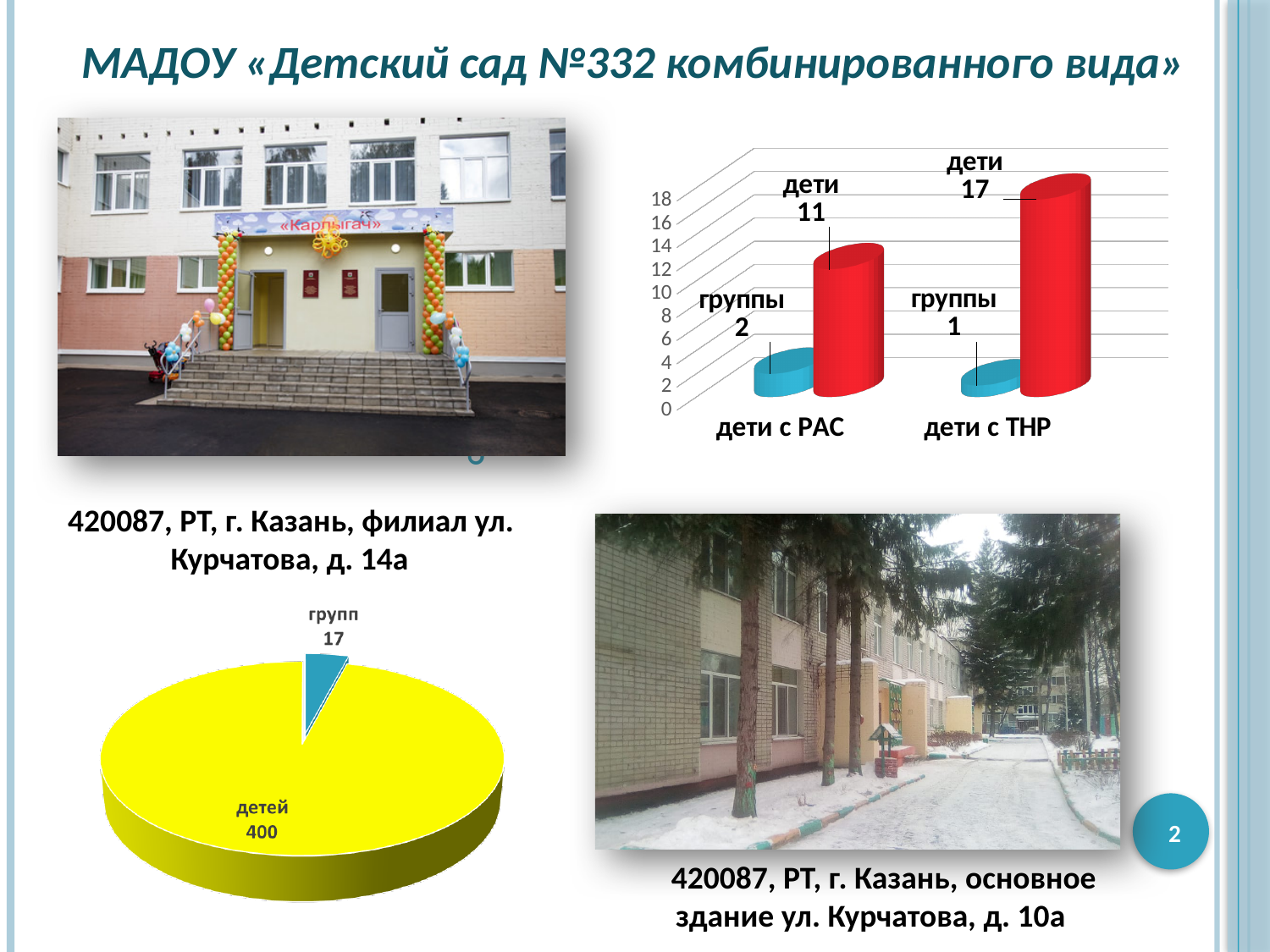
In the bar chart at the top right, how many categories are shown on the x axis? 2 In the bar chart at the top right, what is the difference in "дети" between "дети с ТНР" and "дети с РАС"? 6 In the pie chart at the bottom left, what is the value of the "групп" slice? 17 In the pie chart at the bottom left, what is the value of the "детей" slice? 400 What kind of chart is shown at the top right of the slide? bar chart What kind of chart is shown at the bottom left of the slide? pie chart In the bar chart at the top right, which category has more "дети": "дети с РАС" or "дети с ТНР"? дети с ТНР In the bar chart at the top right, how many "группы" are shown for "дети с РАС"? 2 In the bar chart at the top right, how many "дети" are shown for "дети с РАС"? 11 In the bar chart at the top right, how many "дети" are shown for "дети с ТНР"? 17 In the bar chart at the top right, how many "группы" are shown for "дети с ТНР"? 1 In the pie chart at the bottom left, which slice is larger: "детей" or "групп"? детей